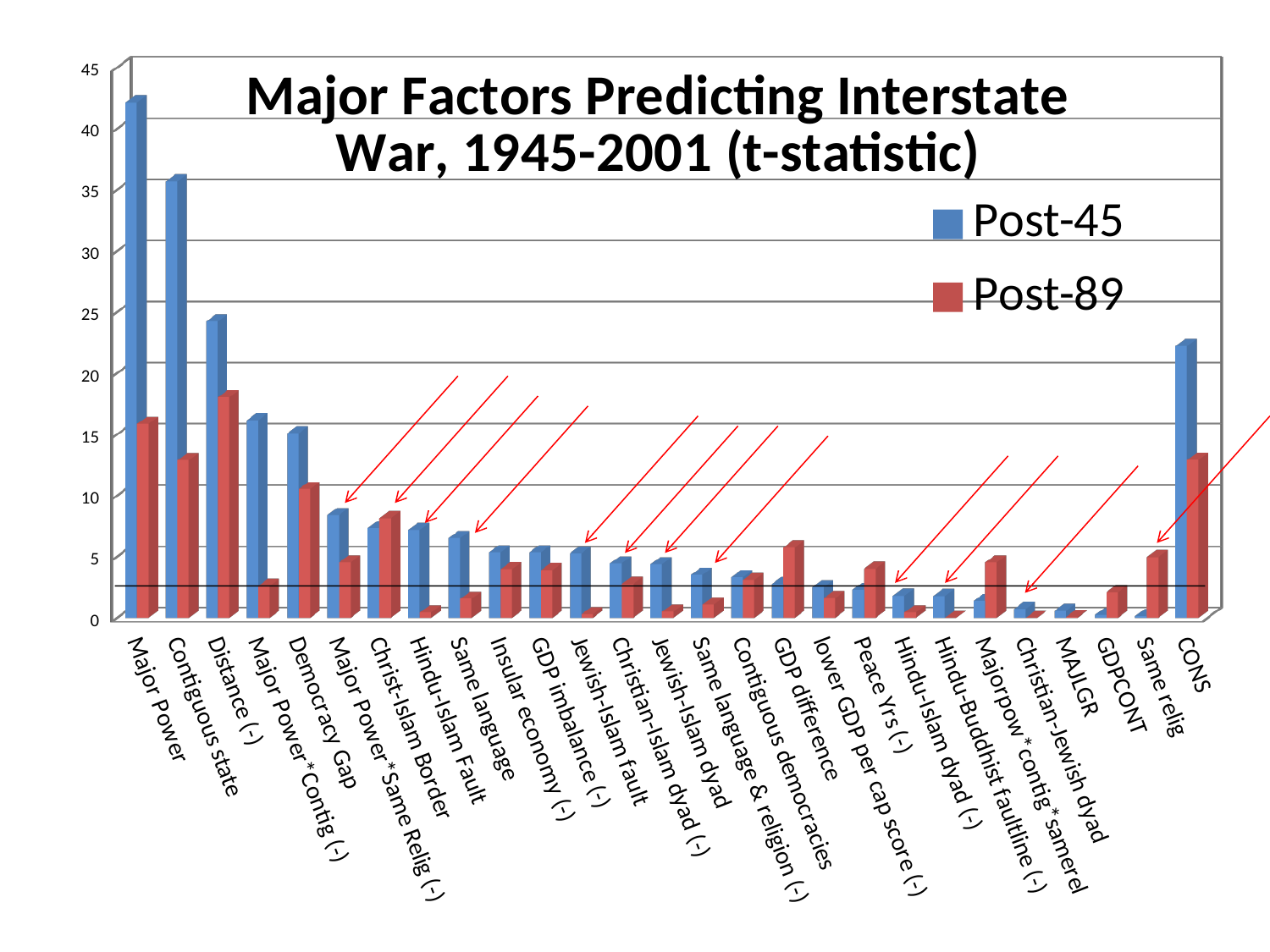
How many series does the legend list? 2 For Major Power, which series has the larger value, Post-45 or Post-89? Post-45 What type of chart is shown on the slide? bar chart How many categories are shown along the x axis? 27 Is the Post-45 value for Major Power greater or less than 40? greater For GDP difference, which series has the larger value, Post-45 or Post-89? Post-89 Which category has the highest Post-89 value? Distance (-) Is the Post-89 value for Major Power greater or less than 10? greater Is the Post-45 value for CONS greater or less than 20? greater Which category has the highest Post-45 value? Major Power What are the two series named in the legend? Post-45 and Post-89